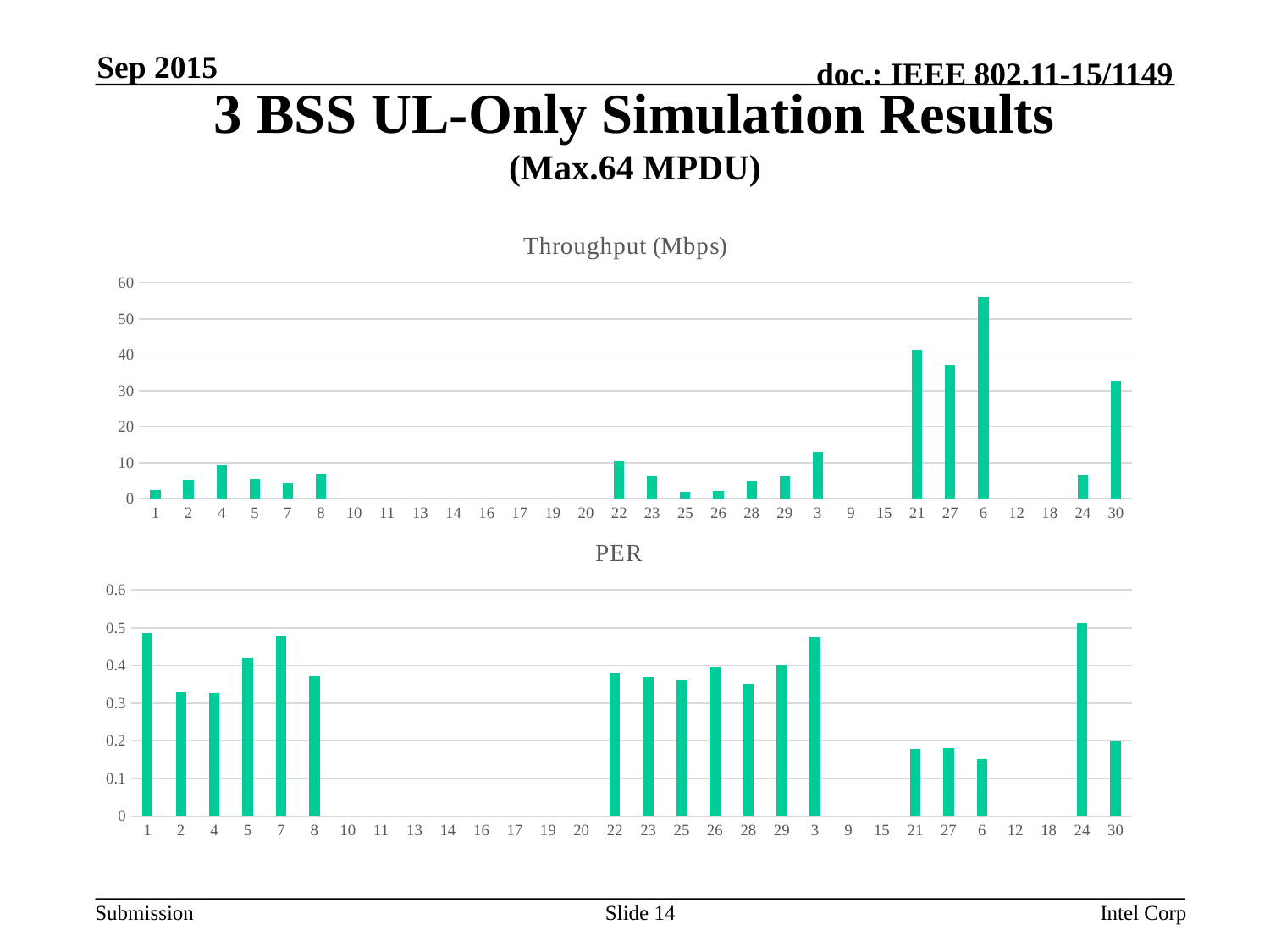
What is the title of the lower chart on the slide? PER In the PER chart, is the value for category 1 greater or less than 0.4? greater In the Throughput (Mbps) chart, is the value for category 6 greater or less than 50? greater In the PER chart, which is larger, the value for category 7 or category 2? 7 What kind of chart is the Throughput (Mbps) chart? bar chart In the Throughput (Mbps) chart, is the value for category 27 greater or less than 40? less How many categories are shown on the x axis of the PER chart? 30 In the PER chart, which of the categories with a visible bar has the lowest PER? 6 In the Throughput (Mbps) chart, which category has the highest throughput? 6 In the Throughput (Mbps) chart, which is larger, the value for category 21 or category 27? 21